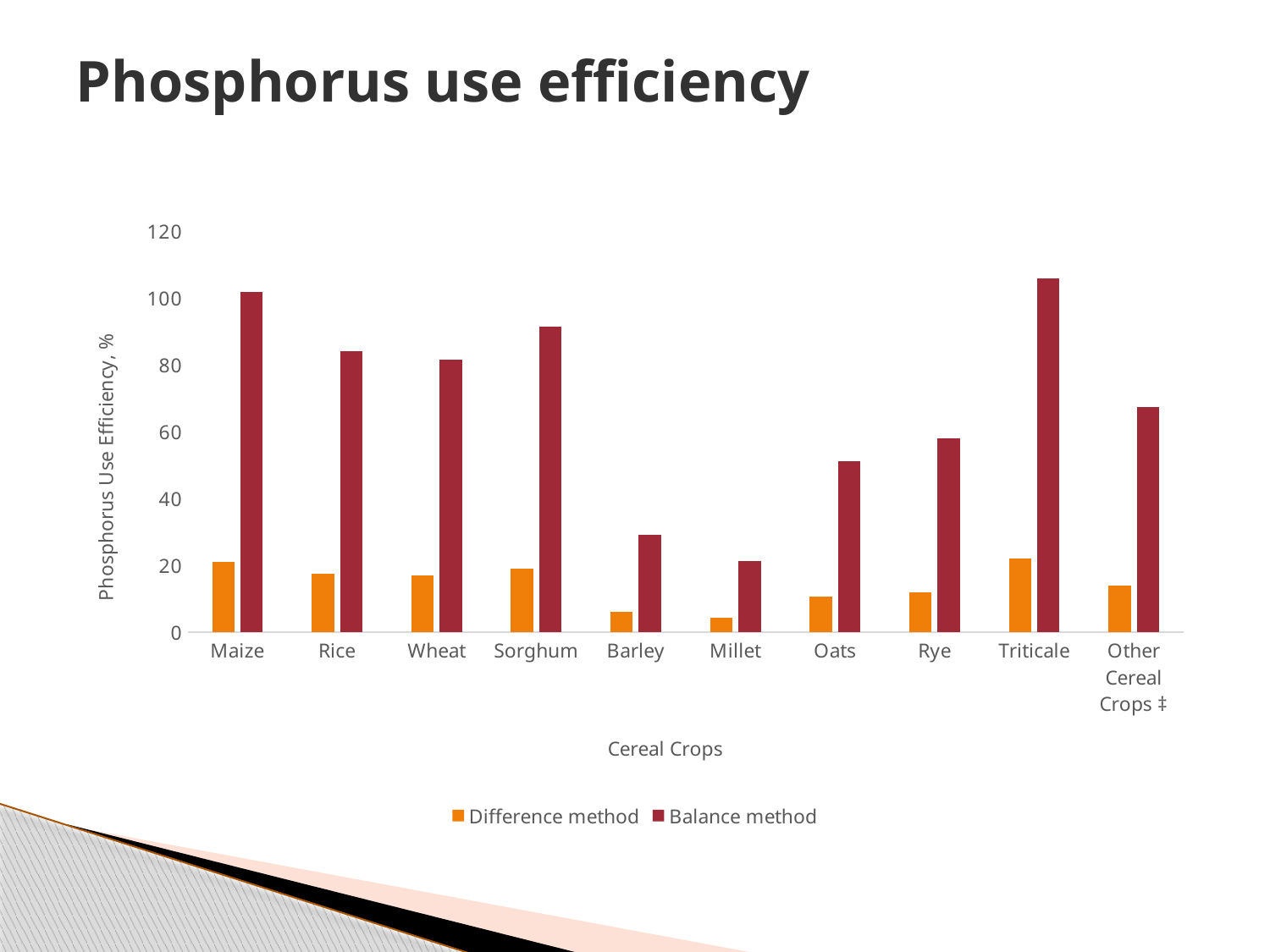
Which cereal crop has the lowest Difference method value? Millet Which has the larger Balance method value, Oats or Rye? Rye Which has the larger Balance method value, Sorghum or Rice? Sorghum What kind of chart is shown on the slide? bar chart How many cereal crop categories are shown on the x axis? 10 Is the Balance method value for Triticale greater or less than 100? greater Is the Difference method value for Millet greater or less than 20? less What is the title of the y axis? Phosphorus Use Efficiency, % How many series does the legend list? 2 Is the Balance method value for Barley greater or less than 40? less Which cereal crop has the lowest Balance method value? Millet